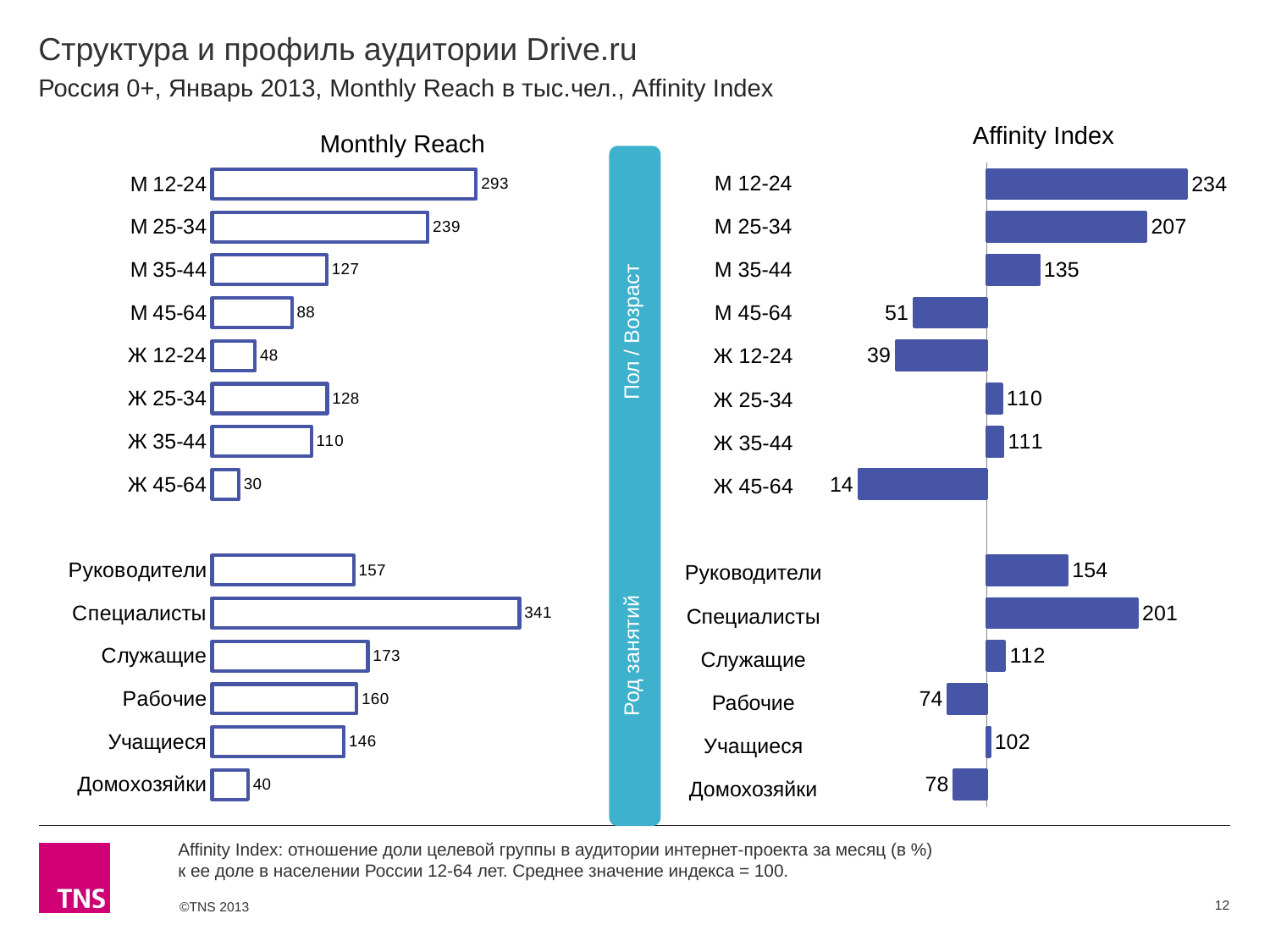
On the Monthly Reach chart, what is the value for М 12-24? 293 On the Affinity Index chart, which category has the lowest value? Ж 45-64 On the Monthly Reach chart, which category has the highest value? Специалисты What kind of chart is the Monthly Reach chart? Bar chart On the Affinity Index chart, what is the value for Специалисты? 201 What are the two group labels shown on the vertical band between the charts? Пол / Возраст and Род занятий On the Monthly Reach chart, what is the value for Домохозяйки? 40 How many categories are plotted on the Affinity Index chart? 14 On the Monthly Reach chart, what is the difference between М 12-24 and М 25-34? 54 On the Affinity Index chart, what is the difference between М 12-24 and Ж 12-24? 195 On the Monthly Reach chart, which category has the lowest value? Ж 45-64 On the Affinity Index chart, which is larger: the value for Руководители or the value for М 35-44? Руководители